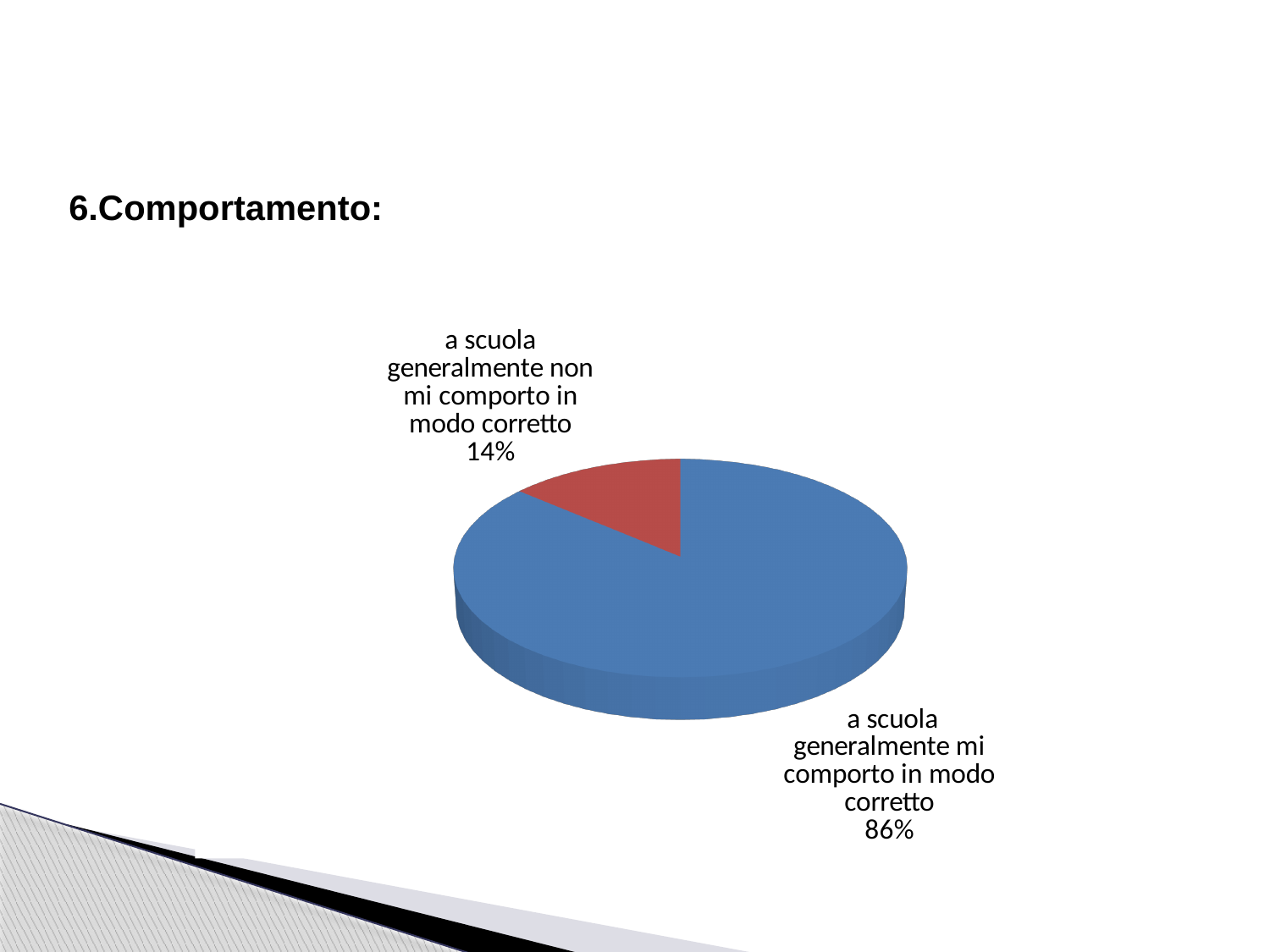
Which is larger: the slice for "a scuola generalmente mi comporto in modo corretto" or the slice for "a scuola generalmente non mi comporto in modo corretto"? a scuola generalmente mi comporto in modo corretto What is the heading text above the chart on the slide? 6.Comportamento: What share of the pie is labelled "a scuola generalmente mi comporto in modo corretto"? 86% How many slices does the pie chart have? 2 Which slice of the pie is the smallest? a scuola generalmente non mi comporto in modo corretto What colour is the slice for "a scuola generalmente non mi comporto in modo corretto"? red Which slice of the pie is the largest? a scuola generalmente mi comporto in modo corretto What kind of chart is shown on the slide? pie chart What share of the pie is labelled "a scuola generalmente non mi comporto in modo corretto"? 14% What is the difference in percentage points between the two slices of the pie? 72